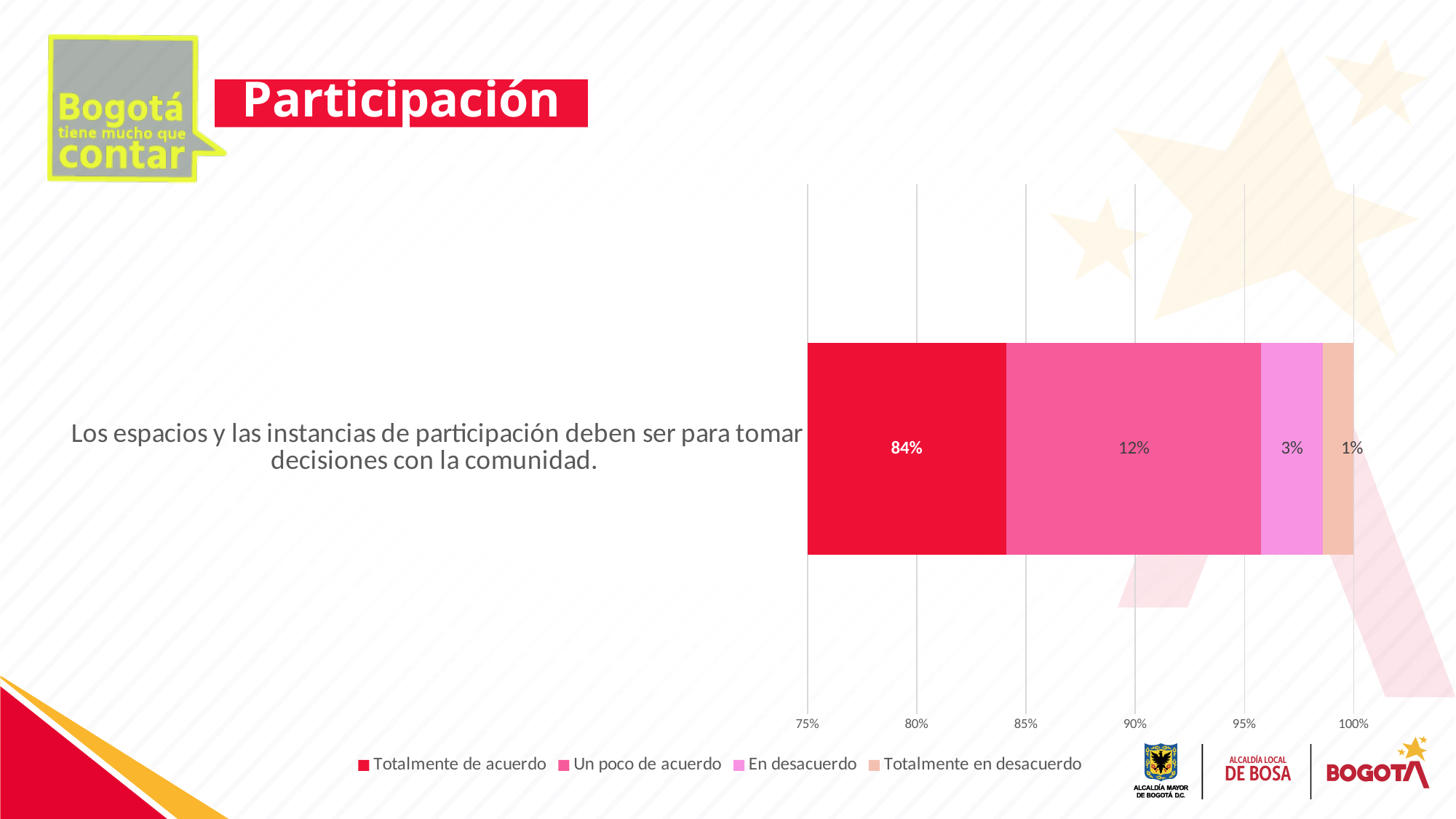
What percentage of respondents answered "Totalmente de acuerdo" to the statement about participation spaces being for making decisions with the community? 84% What is the value shown for "Un poco de acuerdo"? 12% What is the value shown for "En desacuerdo"? 3% What colour is the "Totalmente de acuerdo" segment? Red Which response option has the lowest share in the bar? Totalmente en desacuerdo What is the total of all four segments in the stacked bar? 100% What is the difference between the "Totalmente de acuerdo" and "Un poco de acuerdo" percentages? 72% What kind of chart is shown on the slide? Stacked bar chart Which response option has the highest share in the bar? Totalmente de acuerdo Which is larger, the share for "En desacuerdo" or for "Totalmente en desacuerdo"? En desacuerdo How many series does the legend list? 4 What is the value shown for "Totalmente en desacuerdo"? 1%